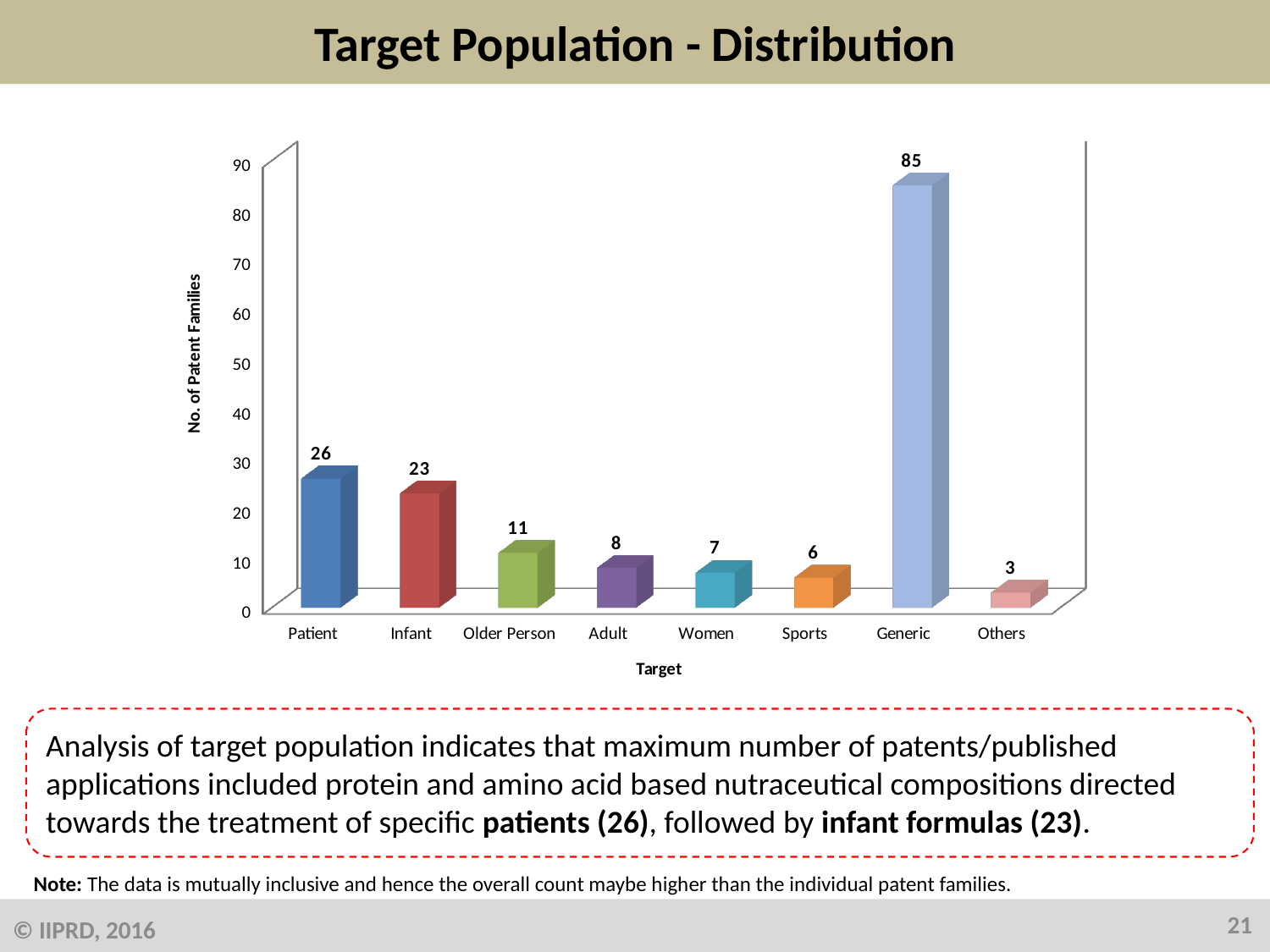
What is the number of patent families for the Sports target? 6 What is the label of the y axis? No. of Patent Families Is the value for Generic greater or less than 80? greater What kind of chart is shown on the slide? Bar chart What is the number of patent families for the Generic target? 85 Which target has the highest number of patent families? Generic What is the difference in patent families between Generic and Patient? 59 How many target categories are shown on the x axis? 8 What is the number of patent families for the Patient target? 26 Which target has the lowest number of patent families? Others Which has more patent families, Older Person or Adult? Older Person What is the difference in patent families between Patient and Infant? 3